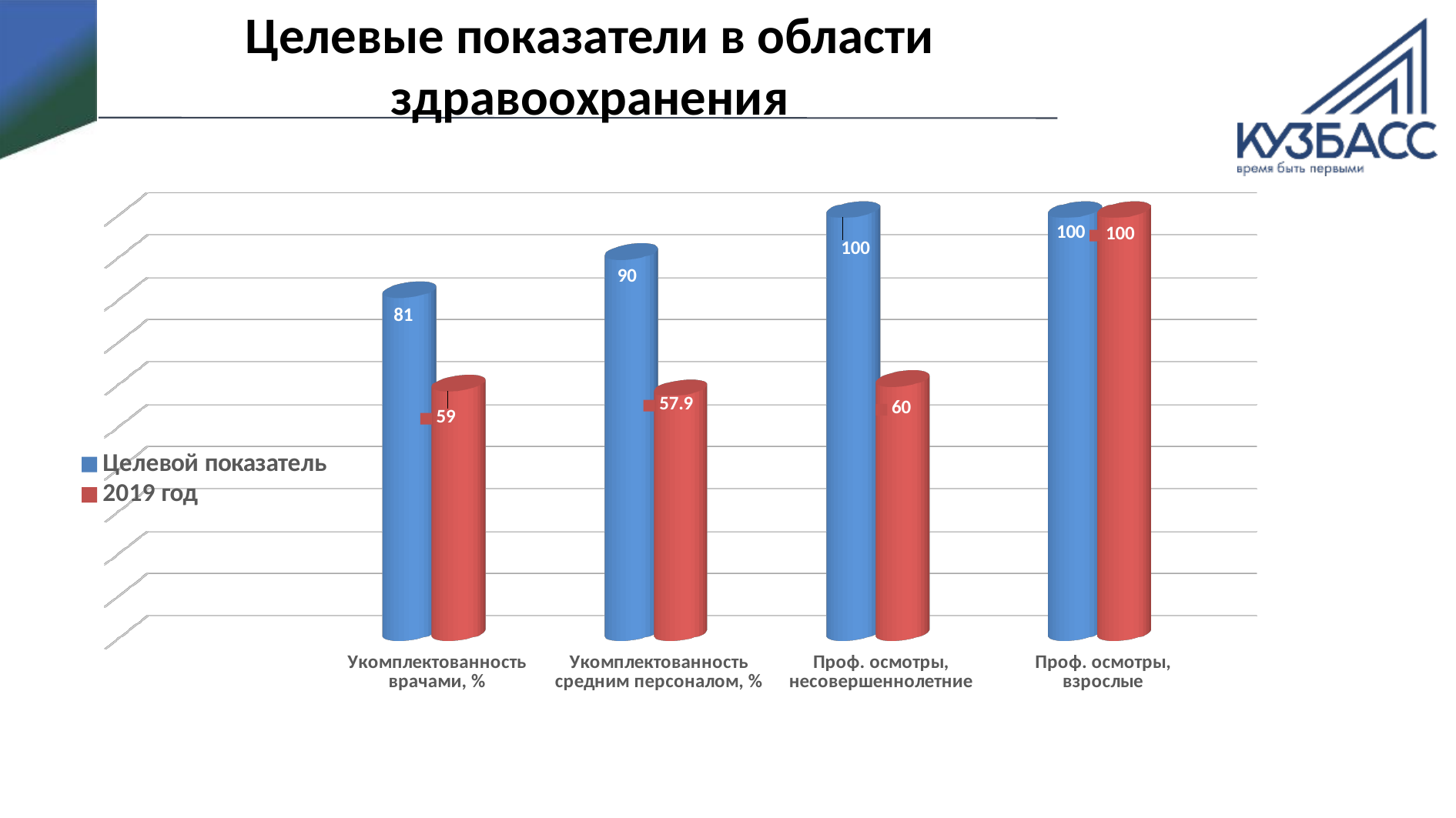
What is the value of "2019 год" for "Укомплектованность средним персоналом, %"? 57.9 What is the value of "Целевой показатель" for "Укомплектованность врачами, %"? 81 What is the value of "2019 год" for "Проф. осмотры, несовершеннолетние"? 60 How many categories are shown on the x axis of the chart? 4 Which is larger for "Укомплектованность средним персоналом, %": "Целевой показатель" or "2019 год"? Целевой показатель Which category has the lowest value for the "2019 год" series? Укомплектованность средним персоналом, % What is the difference between "Целевой показатель" and "2019 год" for "Проф. осмотры, несовершеннолетние"? 40 How many series does the chart legend list? 2 What type of chart is shown on the slide? Bar chart Which category has the lowest value for the "Целевой показатель" series? Укомплектованность врачами, % What is the value of "Целевой показатель" for "Укомплектованность средним персоналом, %"? 90 What is the difference between "Целевой показатель" and "2019 год" for "Укомплектованность врачами, %"? 22